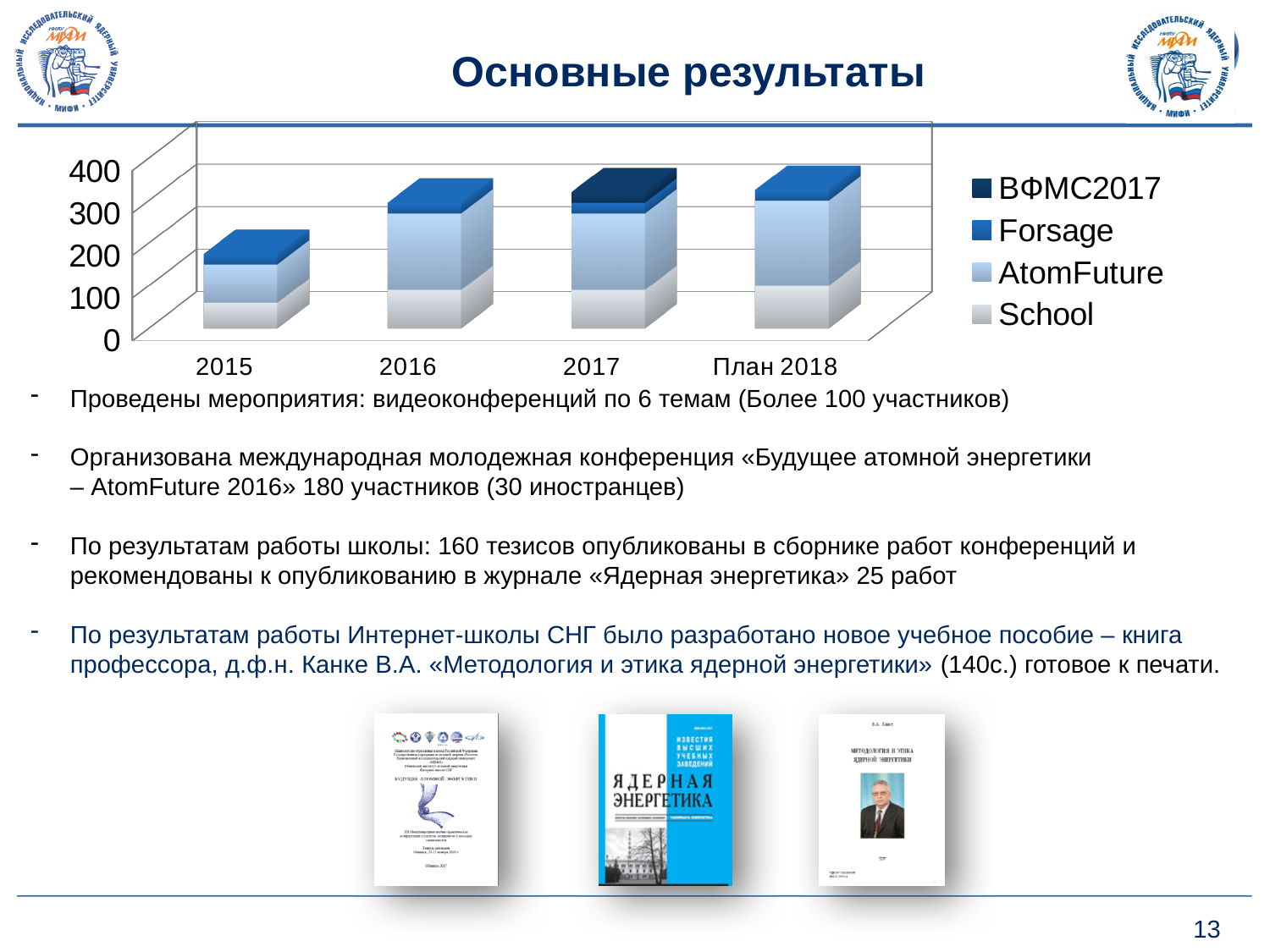
Which series are listed in the chart legend? ВФМС2017, Forsage, AtomFuture, School Which is larger, the total bar for 2015 or the total bar for 2016? 2016 How many categories are shown along the x axis of the chart? 4 Is the total bar for 2015 greater or less than 300? less How many series does the chart legend list? 4 Do the total bar heights rise or fall from 2015 to 2017? rise Is the total bar for 2016 greater or less than 200? greater What kind of chart is shown on the slide? Stacked bar chart What is the last category label on the x axis? План 2018 Which series appears only in the 2017 bar? ВФМС2017 Which category on the x axis has the lowest total bar? 2015 Is the total bar for 2017 greater or less than 200? greater